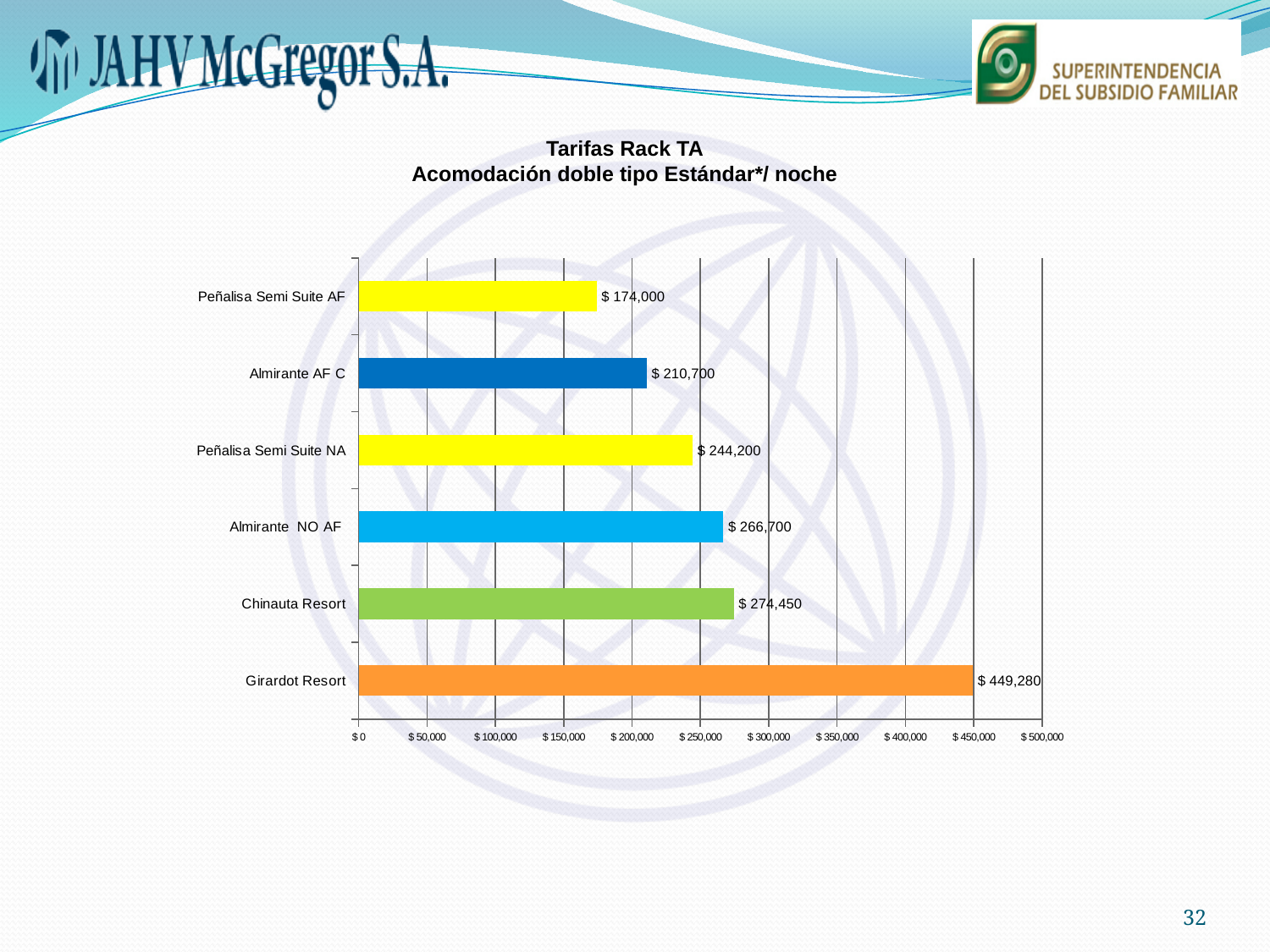
What is the value for Peñalisa Semi Suite AF? $ 174,000 How many categories are shown in the chart? 6 Which category has the lowest value? Peñalisa Semi Suite AF What kind of chart is shown on the slide? bar chart What is the title of the chart? Tarifas Rack TA Acomodación doble tipo Estándar*/ noche What is the value for Almirante NO AF? $ 266,700 Which is larger, the value for Almirante AF C or the value for Peñalisa Semi Suite NA? Peñalisa Semi Suite NA Is the value for Chinauta Resort greater or less than $ 250,000? greater What is the difference between the values for Girardot Resort and Chinauta Resort? $ 174,830 What is the value for Girardot Resort? $ 449,280 What is the difference between the values for Peñalisa Semi Suite NA and Peñalisa Semi Suite AF? $ 70,200 Which category has the highest value? Girardot Resort